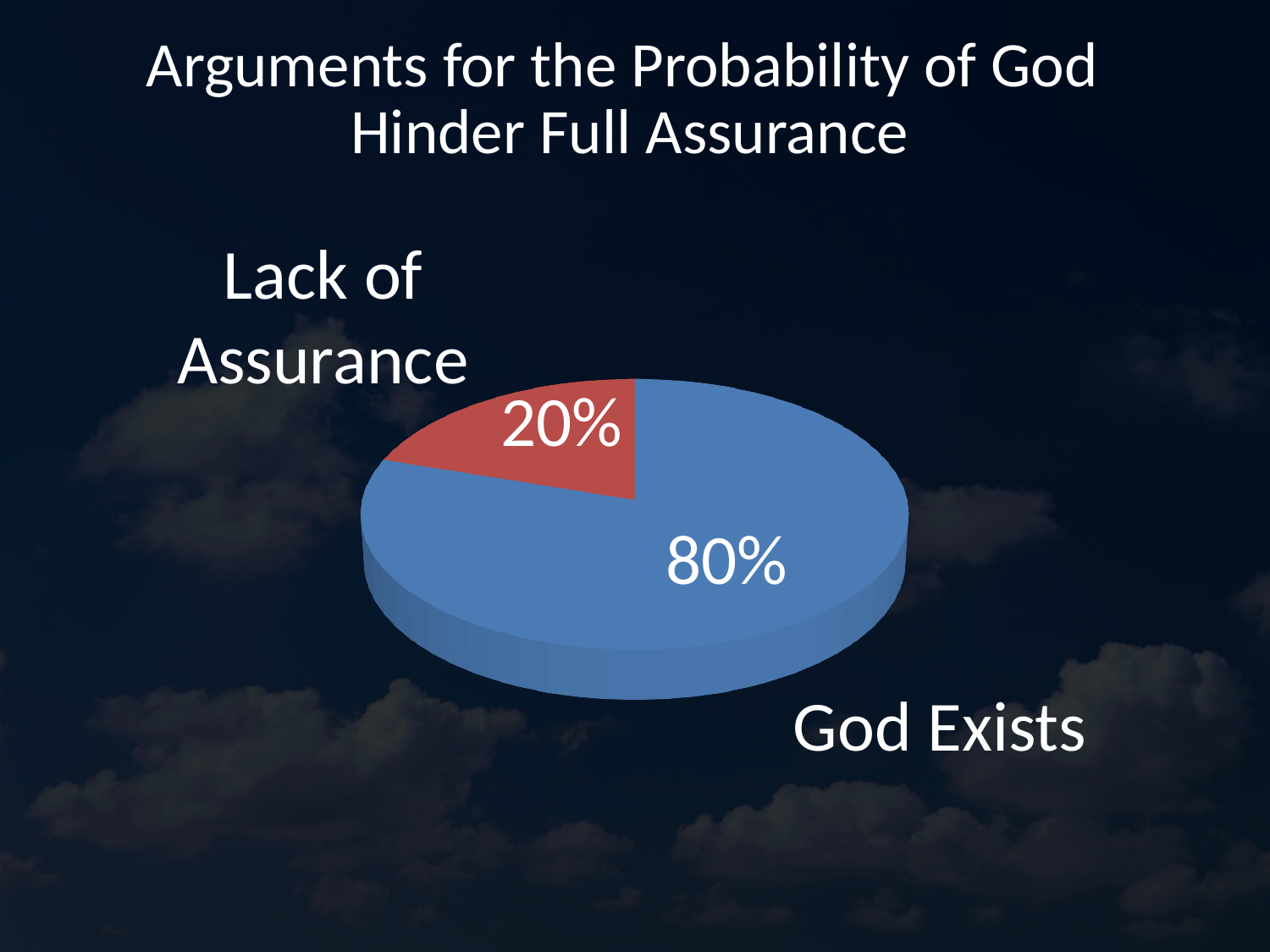
How many slices does the pie chart have? 2 What is the difference in percentage points between the "God Exists" slice and the "Lack of Assurance" slice? 60 Which slice of the pie is the smallest? Lack of Assurance Which slice of the pie is the largest? God Exists What is the title of the slide containing the pie chart? Arguments for the Probability of God Hinder Full Assurance What kind of chart is shown on the slide? pie chart Which is larger, the "God Exists" slice or the "Lack of Assurance" slice? God Exists What percentage of the pie is labelled "God Exists"? 80% What share of the pie does the "Lack of Assurance" slice represent? 20% What percentage of the pie is labelled "Lack of Assurance"? 20% What colour is the "Lack of Assurance" slice? red